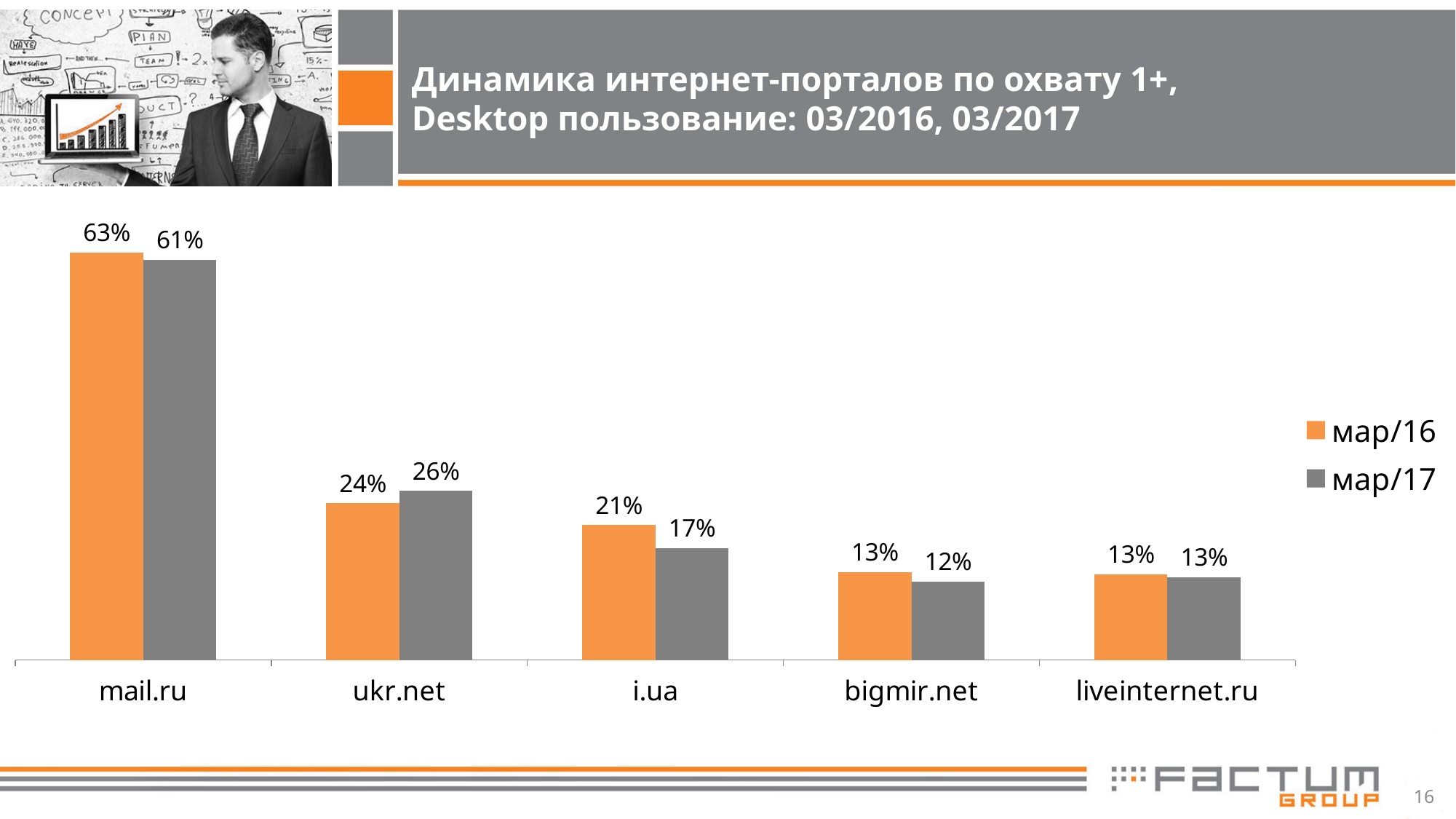
Which portal has the lowest value in the мар/17 series? bigmir.net What is the value for i.ua in the мар/17 series? 17% Which is larger for ukr.net: the мар/16 value or the мар/17 value? мар/17 Which portal has the highest value in the мар/17 series? mail.ru What kind of chart is shown on the slide? bar chart What is the value for bigmir.net in the мар/16 series? 13% How many portals are shown on the x axis? 5 What is the value for mail.ru in the мар/16 series? 63% What is the difference between the мар/16 and мар/17 values for i.ua? 4% How many series does the legend list? 2 What is the value for ukr.net in the мар/17 series? 26% Which colour represents the мар/16 series in the legend? orange